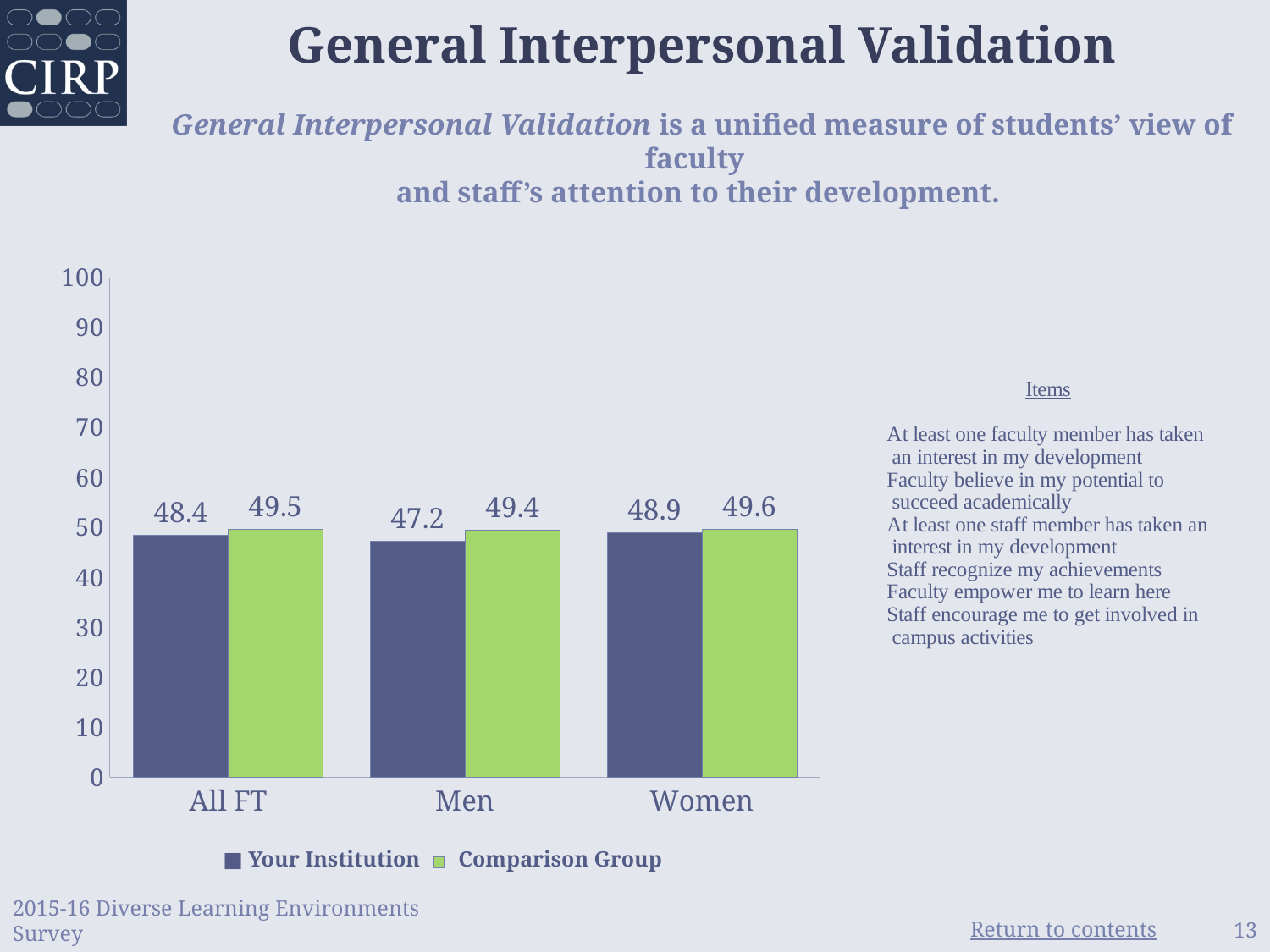
What is the value for Your Institution in the All FT category? 48.4 Which category has the lowest value for Your Institution? Men What is the difference between the Comparison Group and Your Institution values for All FT? 1.1 How many series does the legend list? 2 What is the value for Comparison Group in the Men category? 49.4 How many categories are shown on the x axis? 3 Which is larger for Women: Your Institution or Comparison Group? Comparison Group What is the value for Your Institution in the Women category? 48.9 What is the difference between the Comparison Group and Your Institution values for Men? 2.2 Which category has the highest value for Comparison Group? Women What kind of chart is shown on the slide? bar chart Is the value for Your Institution in the Men category greater or less than 50? less